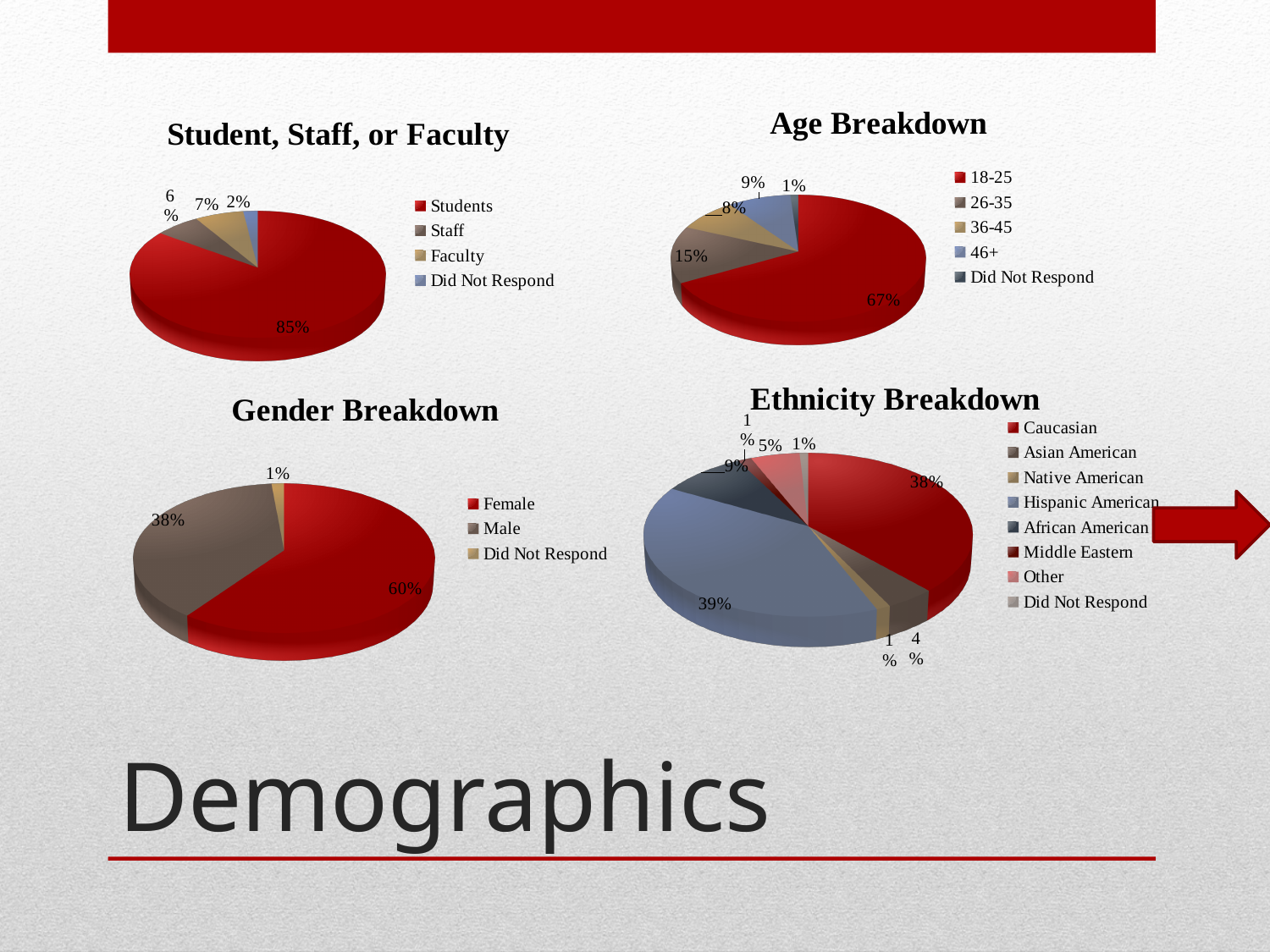
In the 'Age Breakdown' chart, what is the difference between the 18-25 share and the 26-35 share? 52% In the 'Age Breakdown' chart, what percentage is the 26-35 group? 15% In the 'Age Breakdown' chart, which age group has the smallest share? Did Not Respond In the 'Student, Staff, or Faculty' chart, what percentage of respondents are Students? 85% In the 'Student, Staff, or Faculty' chart, how many categories does the legend list? 4 In the 'Student, Staff, or Faculty' chart, what share of the pie is 'Did Not Respond'? 2% In the 'Gender Breakdown' chart, which is larger, Female or Male? Female What type of chart is used for the 'Ethnicity Breakdown'? Pie chart In the 'Age Breakdown' chart, what percentage is the 18-25 group? 67% In the 'Ethnicity Breakdown' chart, what percentage is Hispanic American? 39% In the 'Ethnicity Breakdown' chart, what percentage is African American? 9% In the 'Gender Breakdown' chart, what percentage of respondents are Female? 60%